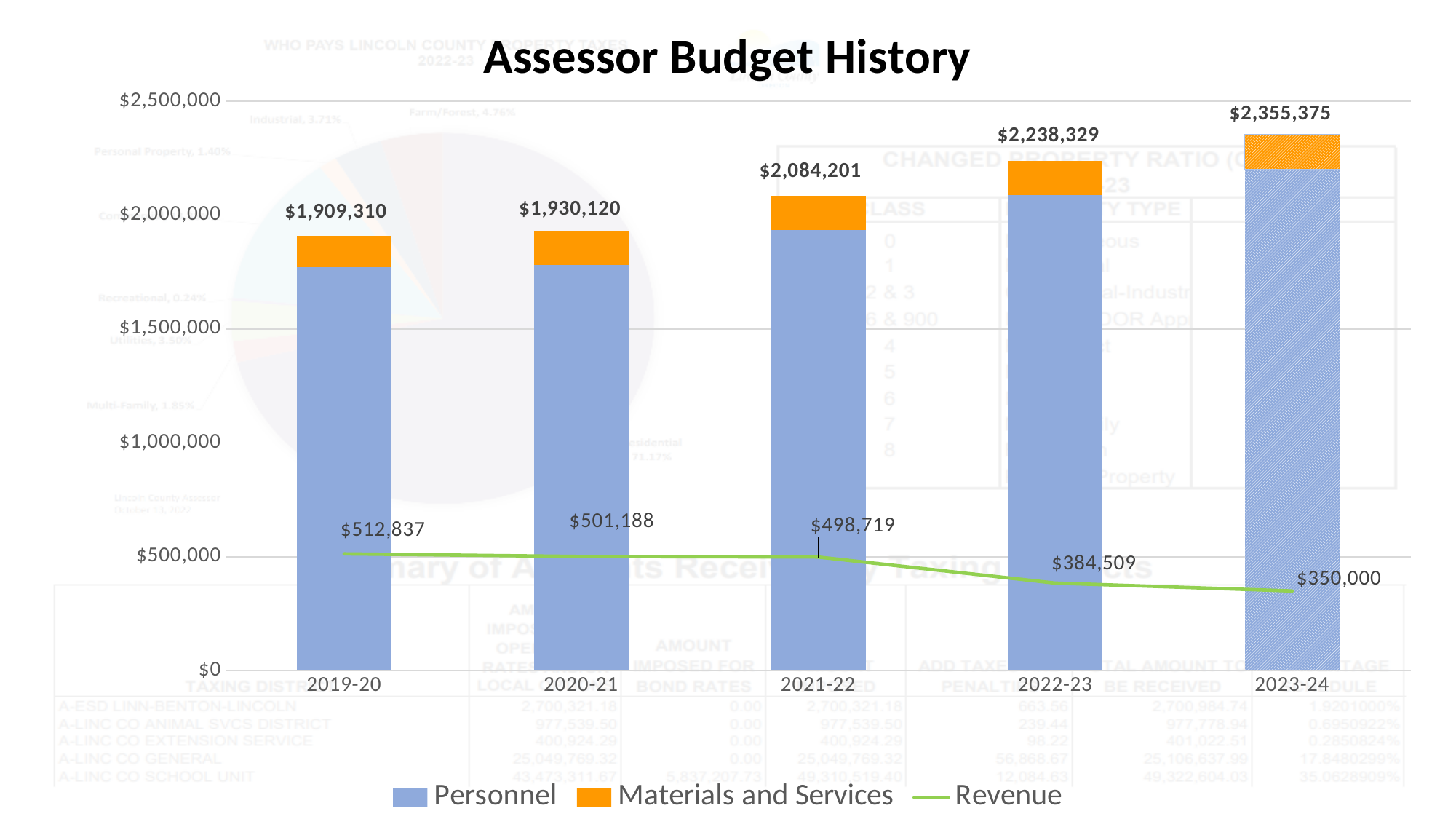
Which year has the highest total budget? 2023-24 What is the total Assessor budget labeled for 2023-24? $2,355,375 How many fiscal years are shown on the x axis? 5 Is the Personnel value for 2023-24 greater or less than $2,000,000? greater What is the total Assessor budget labeled for 2019-20? $1,909,310 Which year has the lowest Revenue? 2023-24 Which is larger, the Revenue for 2019-20 or the Revenue for 2020-21? 2019-20 What is the Revenue value for 2023-24? $350,000 Does the Revenue line rise or fall from 2019-20 to 2023-24? fall What is the difference between the total budget for 2022-23 and 2021-22? $154,128 What is the Revenue value for 2021-22? $498,719 How many series does the legend list? 3